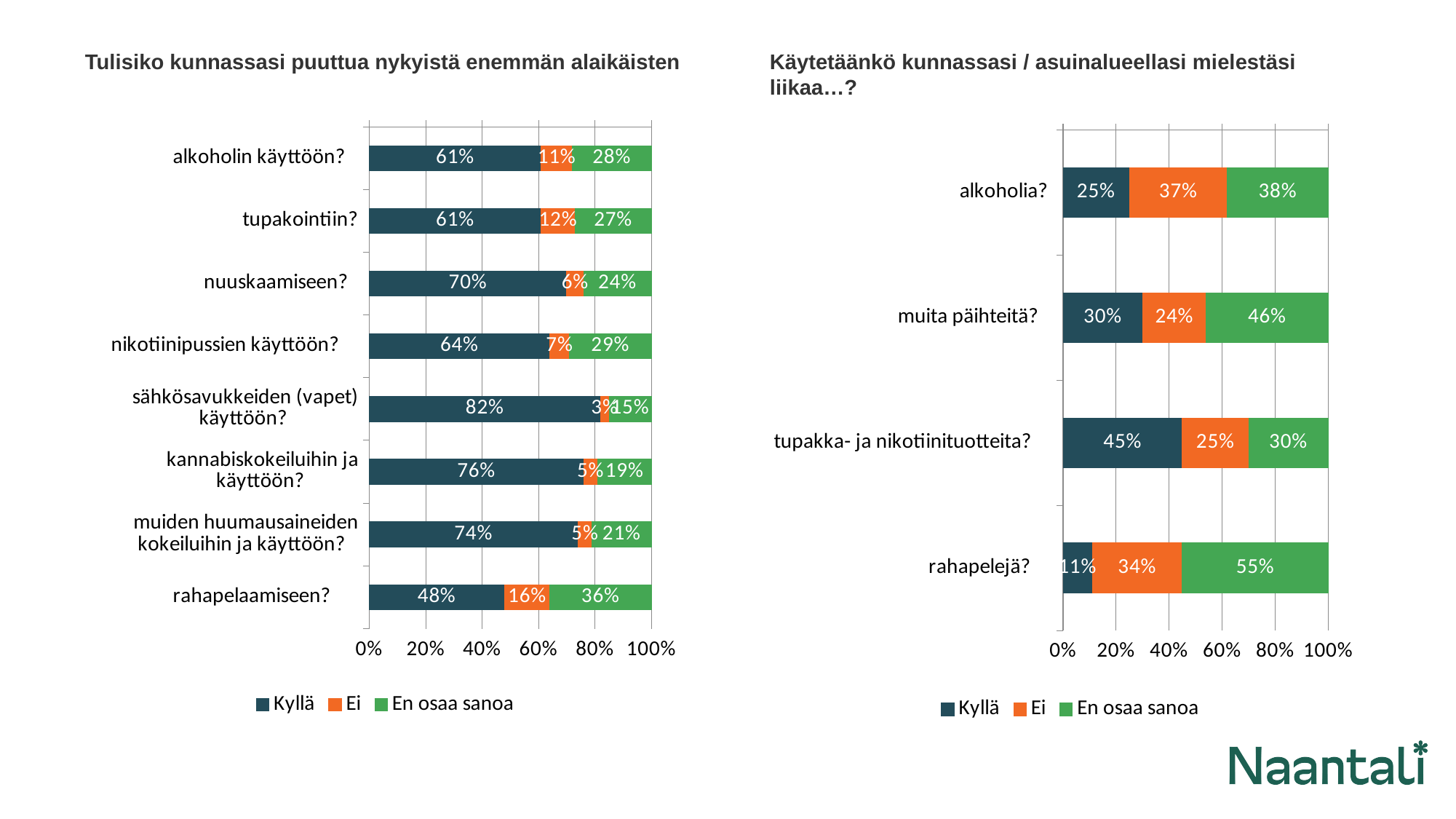
In the left chart ("Tulisiko kunnassasi puuttua nykyistä enemmän alaikäisten"), which category has the highest Kyllä value? sähkösavukkeiden (vapet) käyttöön? In the left chart ("Tulisiko kunnassasi puuttua nykyistä enemmän alaikäisten"), what is the Ei value for "rahapelaamiseen?"? 16% In the right chart ("Käytetäänkö kunnassasi / asuinalueellasi mielestäsi liikaa…?"), what is the En osaa sanoa value for "rahapelejä?"? 55% In the left chart ("Tulisiko kunnassasi puuttua nykyistä enemmän alaikäisten"), how many categories are shown? 8 What kind of chart is the right chart ("Käytetäänkö kunnassasi / asuinalueellasi mielestäsi liikaa…?")? Stacked bar chart In the right chart ("Käytetäänkö kunnassasi / asuinalueellasi mielestäsi liikaa…?"), which category has the highest Kyllä value? tupakka- ja nikotiinituotteita? In the left chart ("Tulisiko kunnassasi puuttua nykyistä enemmän alaikäisten"), what is the difference between the Kyllä values for "sähkösavukkeiden (vapet) käyttöön?" and "rahapelaamiseen?"? 34 percentage points In the left chart ("Tulisiko kunnassasi puuttua nykyistä enemmän alaikäisten"), what is the Kyllä value for "nuuskaamiseen?"? 70% In the right chart ("Käytetäänkö kunnassasi / asuinalueellasi mielestäsi liikaa…?"), what is the total of the stacked bar for "muita päihteitä?"? 100% In the right chart ("Käytetäänkö kunnassasi / asuinalueellasi mielestäsi liikaa…?"), how many series does the legend list? 3 In the left chart ("Tulisiko kunnassasi puuttua nykyistä enemmän alaikäisten"), which category has the lowest Kyllä value? rahapelaamiseen? In the right chart ("Käytetäänkö kunnassasi / asuinalueellasi mielestäsi liikaa…?"), is the Ei value for "alkoholia?" larger or smaller than the Ei value for "muita päihteitä?"? larger